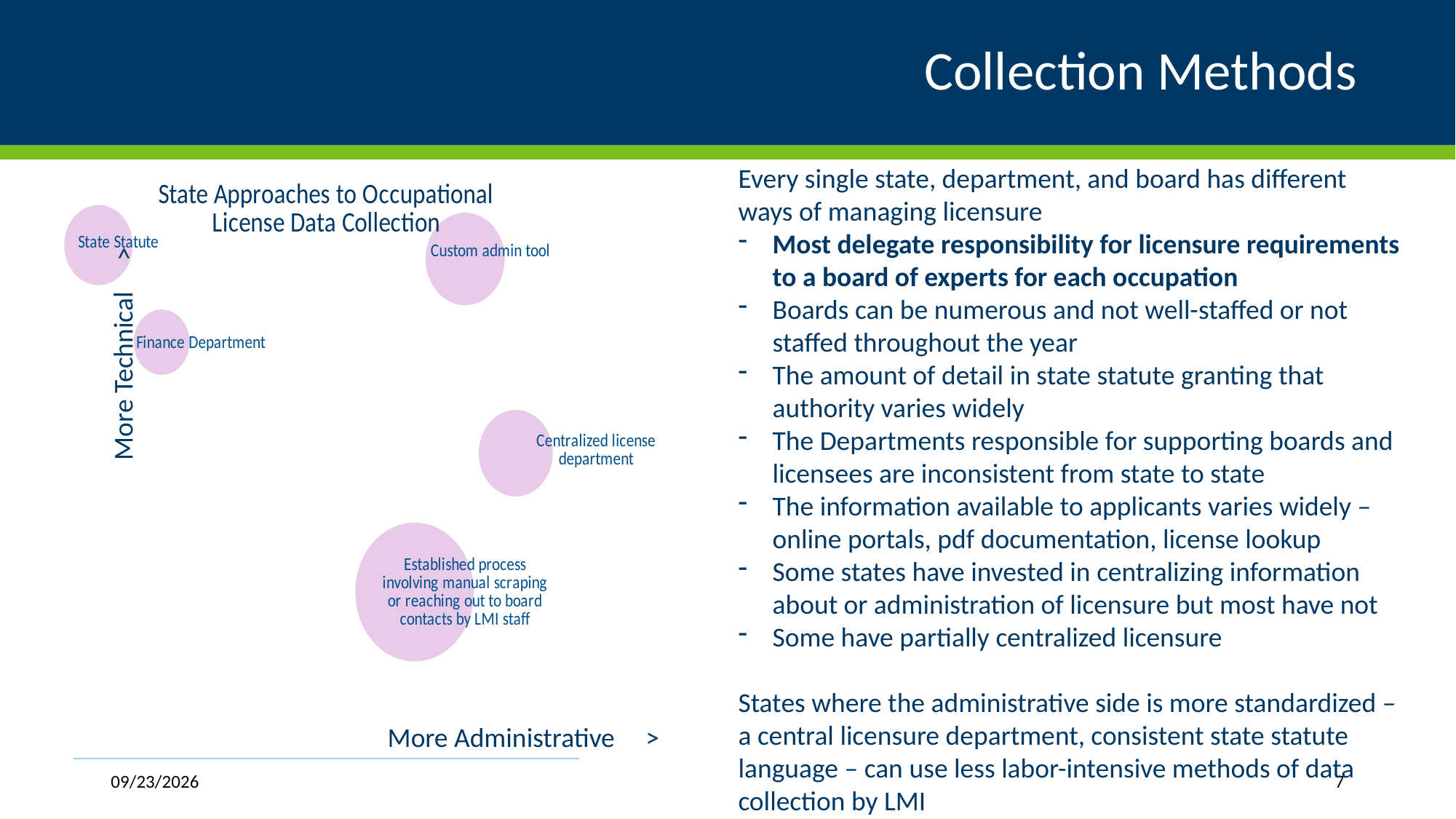
Which bubble is positioned furthest along the 'More Administrative' axis? Centralized license department What kind of chart is shown on the slide? Bubble chart Which bubble in the chart is the smallest? Finance Department What label is shown on the horizontal axis of the chart? More Administrative How many bubbles are plotted in the chart? 5 What is the title of the chart on the slide? State Approaches to Occupational License Data Collection Which is positioned higher on the 'More Technical' axis: Custom admin tool or Centralized license department? Custom admin tool Which bubble is positioned highest on the 'More Technical' axis? State Statute Which is positioned further toward 'More Administrative': Custom admin tool or Finance Department? Custom admin tool Which bubble is positioned lowest on the 'More Technical' axis? Established process involving manual scraping or reaching out to board contacts by LMI staff Which bubble in the chart is the largest? Established process involving manual scraping or reaching out to board contacts by LMI staff